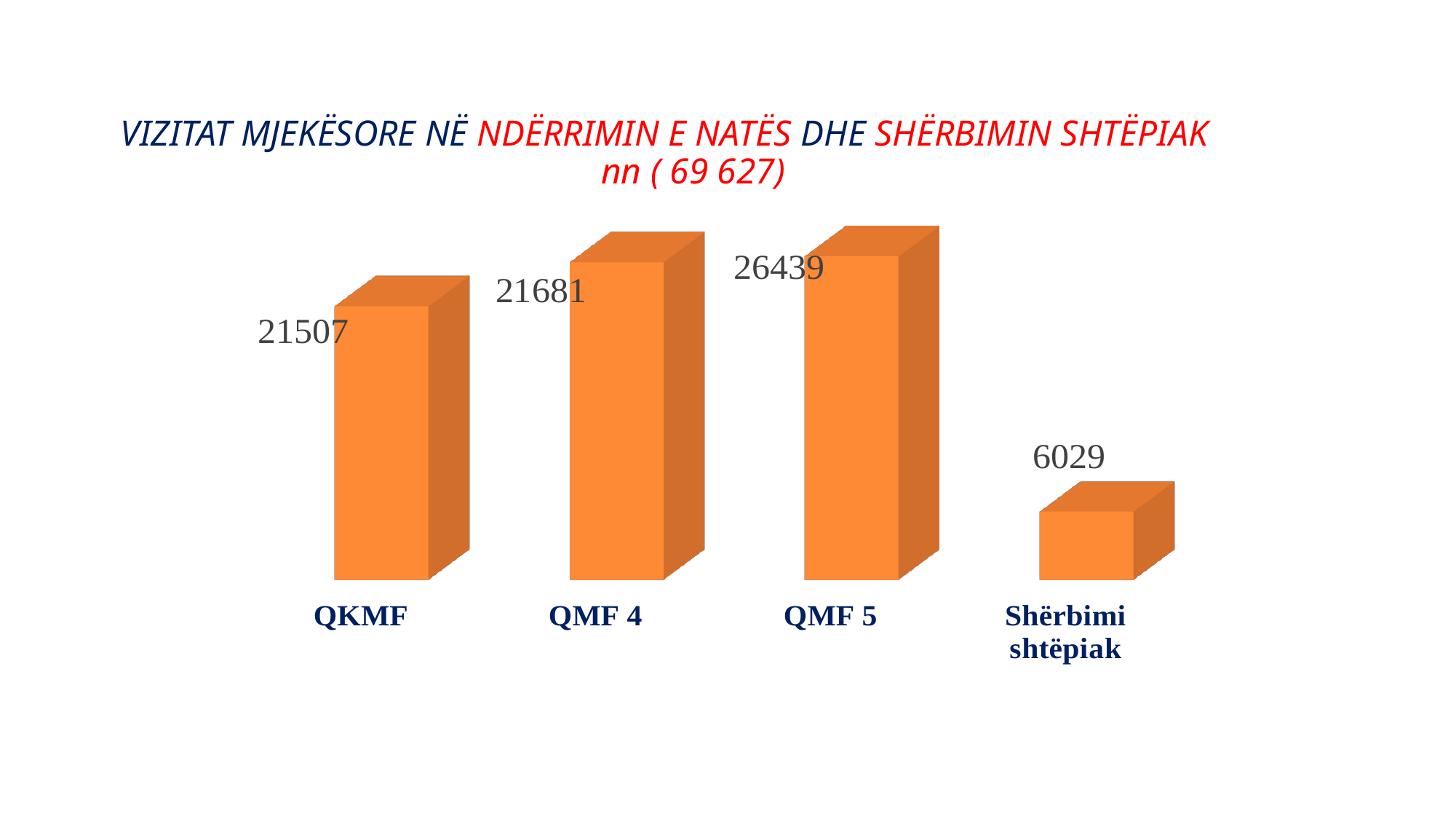
What kind of chart is shown on the slide? bar chart What is the difference between the values for QKMF and Shërbimi shtëpiak? 15478 What is the difference between the values for QMF 5 and QMF 4? 4758 What is the value for QMF 5? 26439 What is the value for Shërbimi shtëpiak? 6029 Which category has the highest value? QMF 5 What total is given in the chart title in parentheses? 69 627 How many categories are shown in the chart? 4 Which is larger, the value for QMF 5 or the value for QKMF? QMF 5 What is the value for QKMF? 21507 Which category has the lowest value? Shërbimi shtëpiak What is the value for QMF 4? 21681